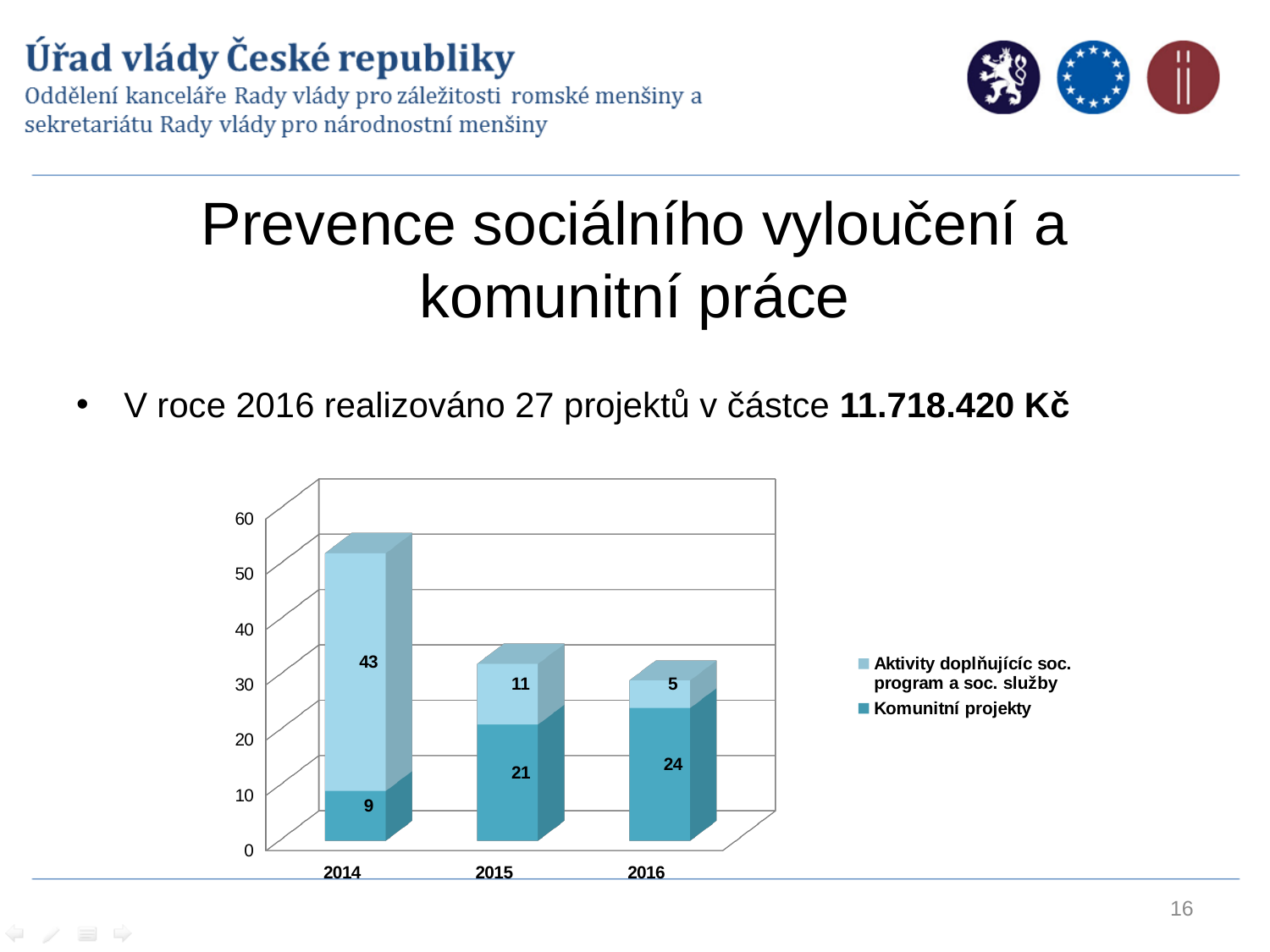
What is the value for Komunitní projekty in 2016? 24 What is the total of the stacked bar for 2016? 29 What kind of chart is shown on the slide? Stacked bar chart What is the value for Aktivity doplňujícíc soc. program a soc. služby in 2015? 11 In which year is the value for Komunitní projekty highest? 2016 What is the value for Komunitní projekty in 2014? 9 In which year is the value for Aktivity doplňujícíc soc. program a soc. služby lowest? 2016 How many series does the legend list? 2 What is the total of the stacked bar for 2014? 52 What is the difference between the Komunitní projekty values for 2016 and 2014? 15 What is the value for Aktivity doplňujícíc soc. program a soc. služby in 2014? 43 Which is larger in 2015: Komunitní projekty or Aktivity doplňujícíc soc. program a soc. služby? Komunitní projekty